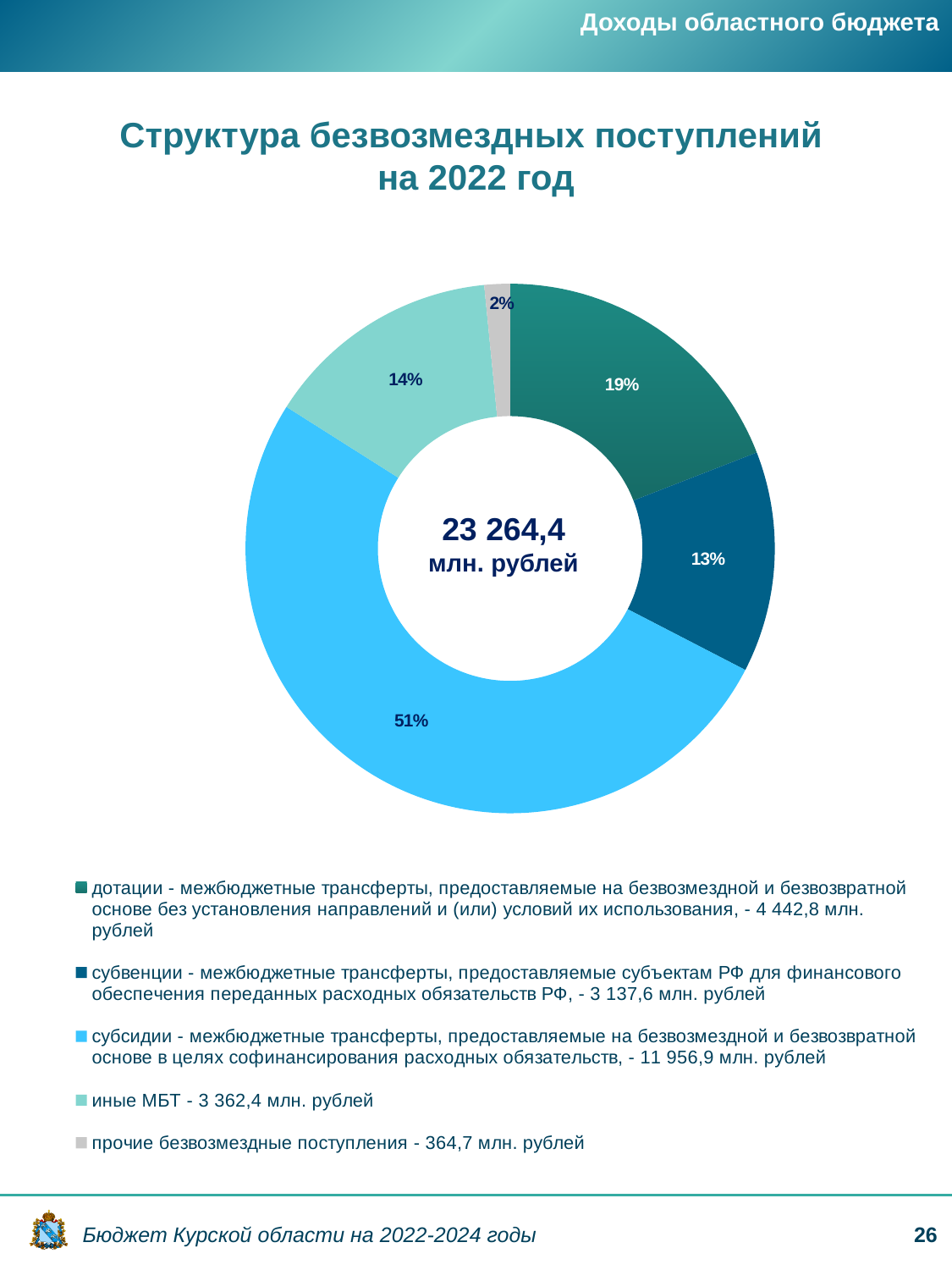
What total value is shown in the centre of the chart? 23 264,4 млн. рублей What share of the chart does the слice for субсидии represent? 51% What percentage is shown for прочие безвозмездные поступления? 2% What percentage is shown for субвенции? 13% Which category has the smallest share of the chart? прочие безвозмездные поступления What is the difference in percentage points between the shares of субсидии and дотации? 32 percentage points Which has a larger share, иные МБТ or субвенции? иные МБТ How many categories does the chart show? 5 Which category has the largest share of the chart? субсидии What percentage is shown for иные МБТ? 14% What percentage is shown for дотации? 19% What kind of chart is shown on the slide? Doughnut (pie) chart